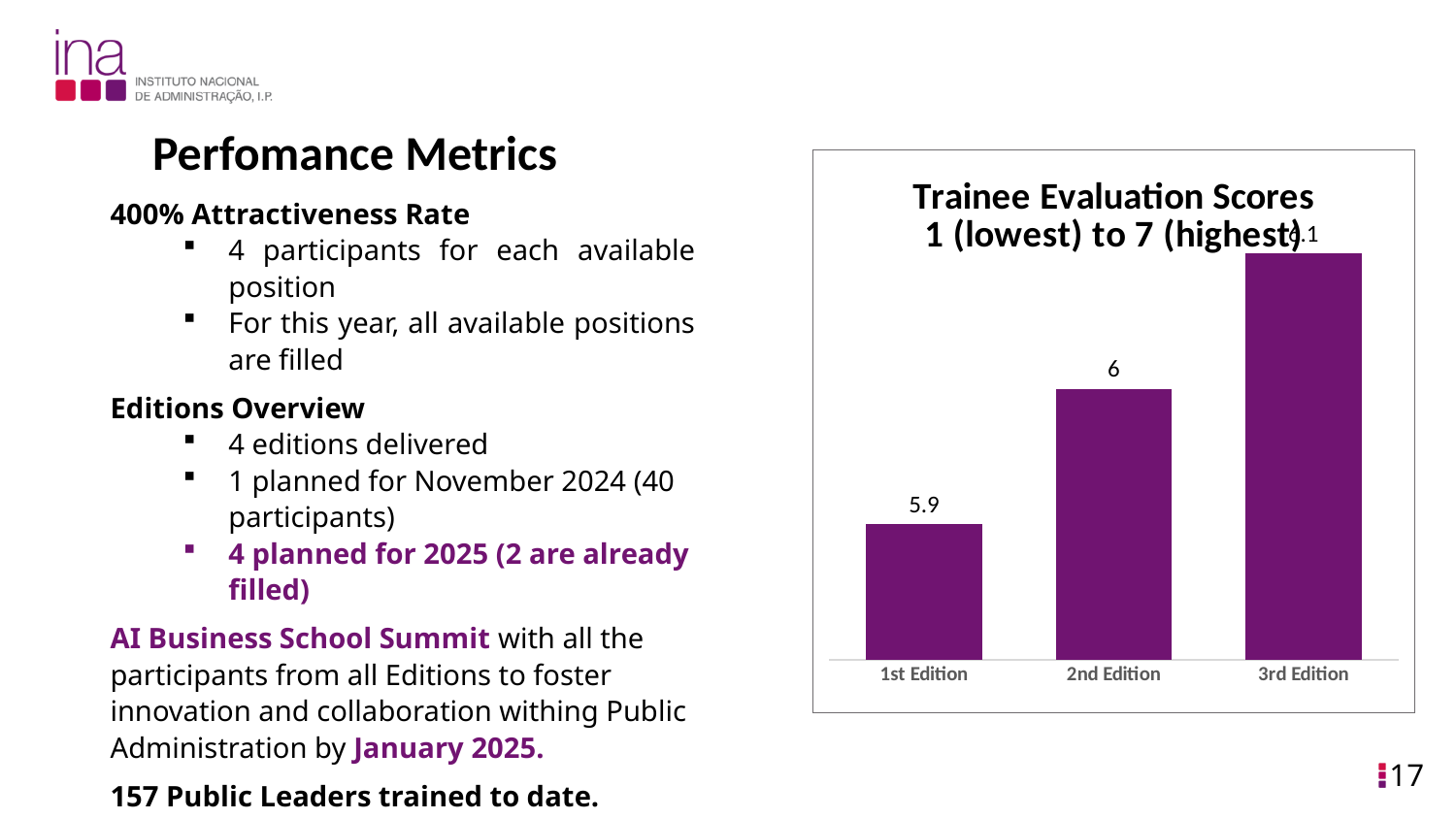
What is the title of the chart on the slide? Trainee Evaluation Scores 1 (lowest) to 7 (highest) Do the trainee evaluation scores rise or fall from the 1st Edition to the 3rd Edition? rise Which edition has the lowest trainee evaluation score? 1st Edition Which has a higher trainee evaluation score, the 2nd Edition or the 3rd Edition? 3rd Edition What colour are the bars in the Trainee Evaluation Scores chart? purple What is the difference between the 2nd Edition and 1st Edition trainee evaluation scores? 0.1 How many editions are shown in the Trainee Evaluation Scores chart? 3 Which edition has the highest trainee evaluation score? 3rd Edition What is the trainee evaluation score for the 1st Edition? 5.9 What type of chart is shown on the slide? bar chart What is the trainee evaluation score for the 3rd Edition? 6.1 What is the trainee evaluation score for the 2nd Edition? 6